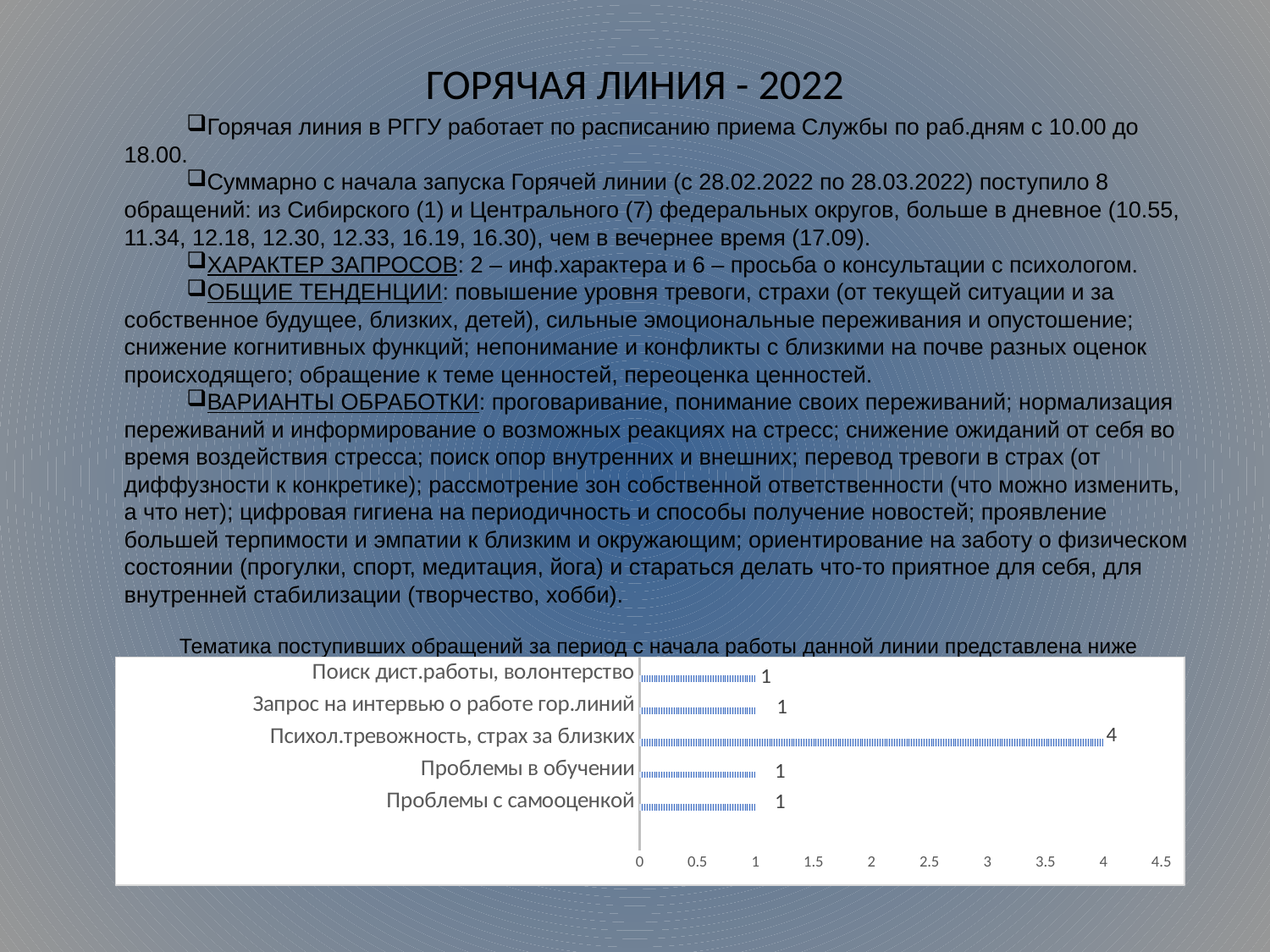
How many categories are shown in the chart? 5 Which category has the highest value? Психол.тревожность, страх за близких What is the value for Поиск дист.работы, волонтерство? 1 Is the value for Психол.тревожность, страх за близких greater or less than 3? greater What kind of chart is shown on the slide? Bar chart What is the value for Проблемы с самооценкой? 1 What is the highest tick value shown on the horizontal axis of the chart? 4.5 What is the difference between the values for Психол.тревожность, страх за близких and Запрос на интервью о работе гор.линий? 3 What is the value for Проблемы в обучении? 1 What is the value for Психол.тревожность, страх за близких? 4 Which is larger: the value for Психол.тревожность, страх за близких or the value for Проблемы с самооценкой? Психол.тревожность, страх за близких Is the value for Запрос на интервью о работе гор.линий greater or less than 2? less